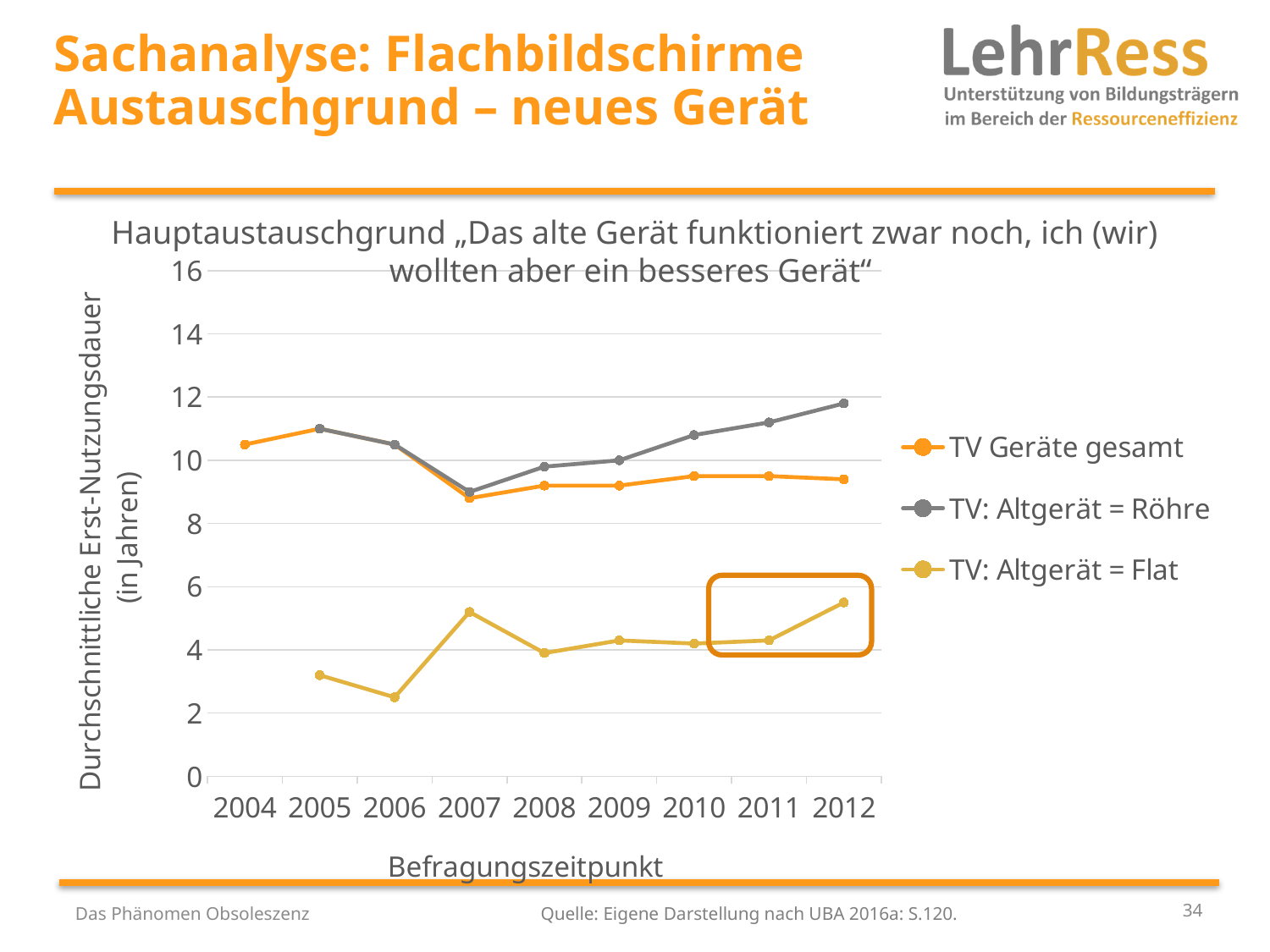
In 2012, which series has the larger value: TV: Altgerät = Röhre or TV Geräte gesamt? TV: Altgerät = Röhre How many series does the legend list? 3 How many years are shown on the x axis? 9 Does the TV: Altgerät = Röhre series rise or fall from 2007 to 2012? rise Is the value for TV Geräte gesamt in 2007 greater or less than 10? less Is the value for TV: Altgerät = Röhre in 2012 greater or less than 10? greater What kind of chart is shown on the slide? line chart In which year does the TV: Altgerät = Flat series reach its lowest value? 2006 Is the value for TV: Altgerät = Flat in 2006 greater or less than 4? less Which series is highlighted by the orange box on the chart? TV: Altgerät = Flat What is the title of the x axis? Befragungszeitpunkt In which year does the TV: Altgerät = Röhre series reach its highest value? 2012